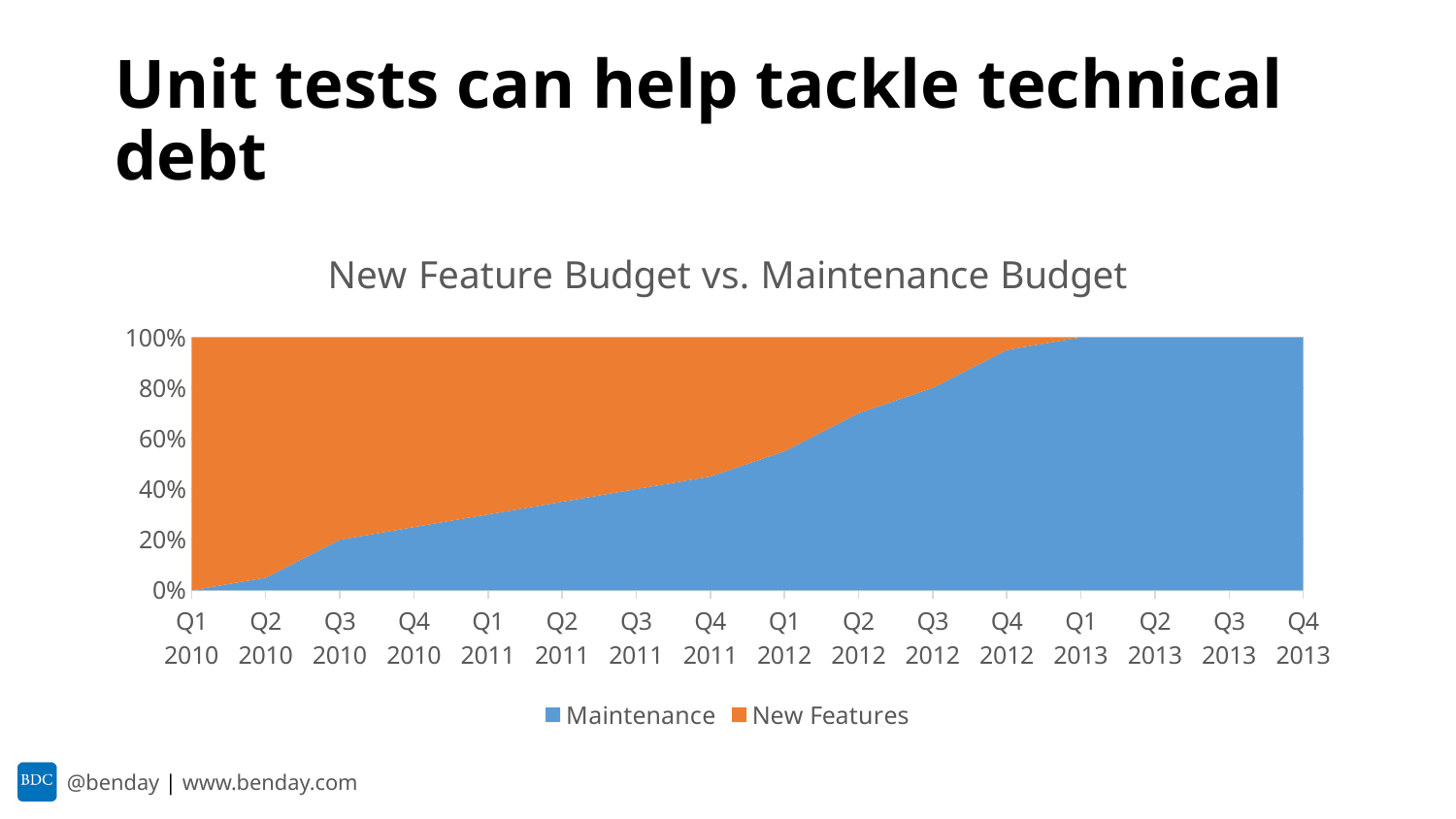
Does the Maintenance share rise or fall from Q1 2010 to Q4 2013? Rise How many quarters are shown along the x axis? 16 Does the New Features share rise or fall from Q1 2010 to Q4 2013? Fall Is the Maintenance share in Q2 2012 greater or less than 60%? greater How many series does the legend list? 2 Which quarter has the lowest Maintenance share? Q1 2010 Is the Maintenance share in Q3 2010 greater or less than 40%? less What type of chart is shown on the slide? Area chart What share of the budget goes to Maintenance in Q4 2013? 100% Is the Maintenance share in Q4 2011 greater or less than 60%? less Which colour represents the Maintenance series? Blue What is the title of the chart? New Feature Budget vs. Maintenance Budget